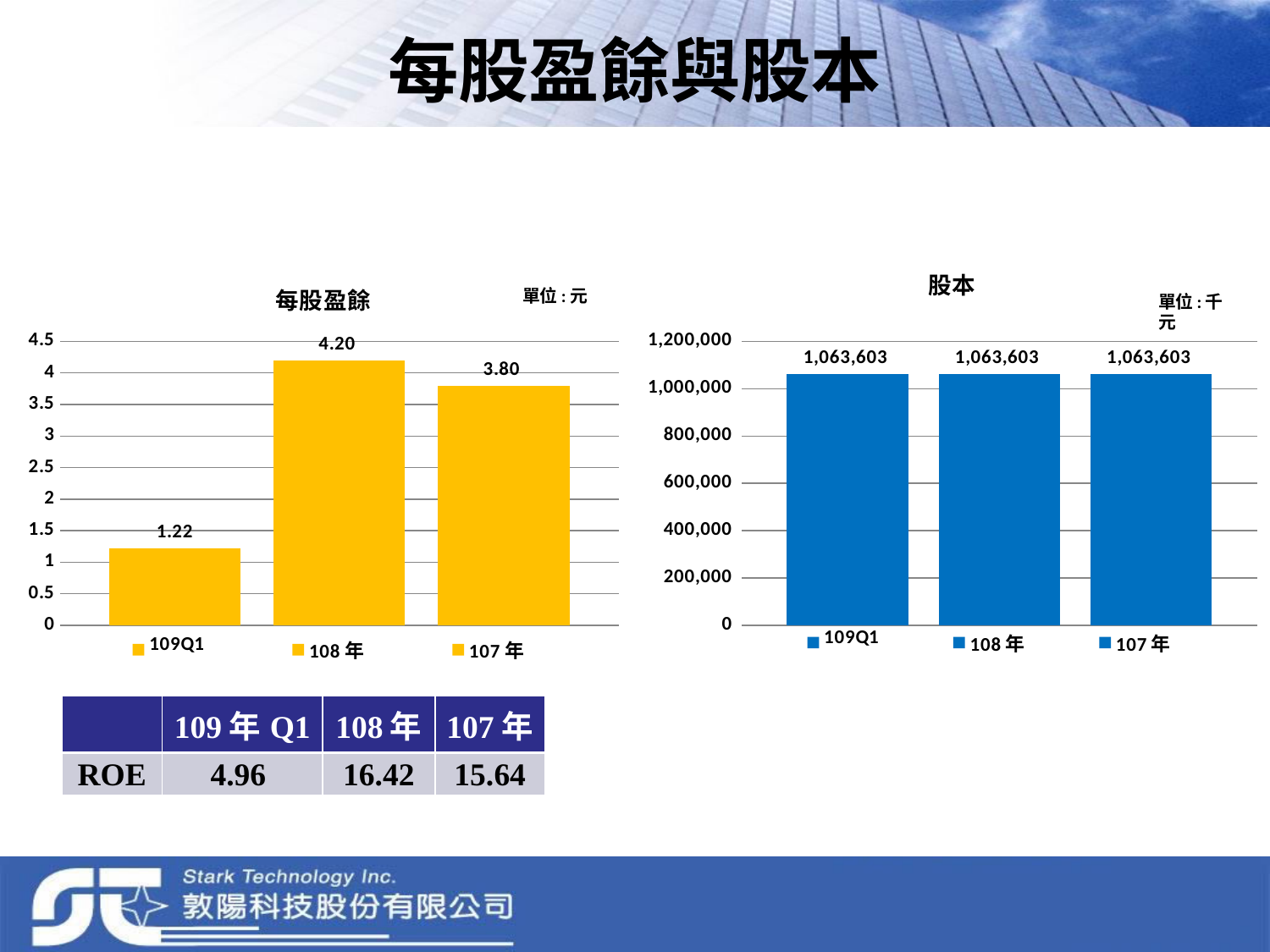
In the 每股盈餘 chart, what is the value for 108 年? 4.20 In the 每股盈餘 chart, which category has the highest value? 108 年 In the 每股盈餘 chart, what is the value for 107 年? 3.80 What kind of chart is the 股本 chart? bar chart In the 每股盈餘 chart, which is larger, the value for 107 年 or the value for 109Q1? 107 年 In the 股本 chart, what is the value for 109Q1? 1,063,603 In the 每股盈餘 chart, which category has the lowest value? 109Q1 In the 每股盈餘 chart, is the value for 109Q1 greater or less than 1.5? less In the 股本 chart, how many bars are plotted? 3 In the 每股盈餘 chart, what is the value for 109Q1? 1.22 In the 每股盈餘 chart, what is the difference between the values for 108 年 and 107 年? 0.40 What unit is shown for the 每股盈餘 chart? 元